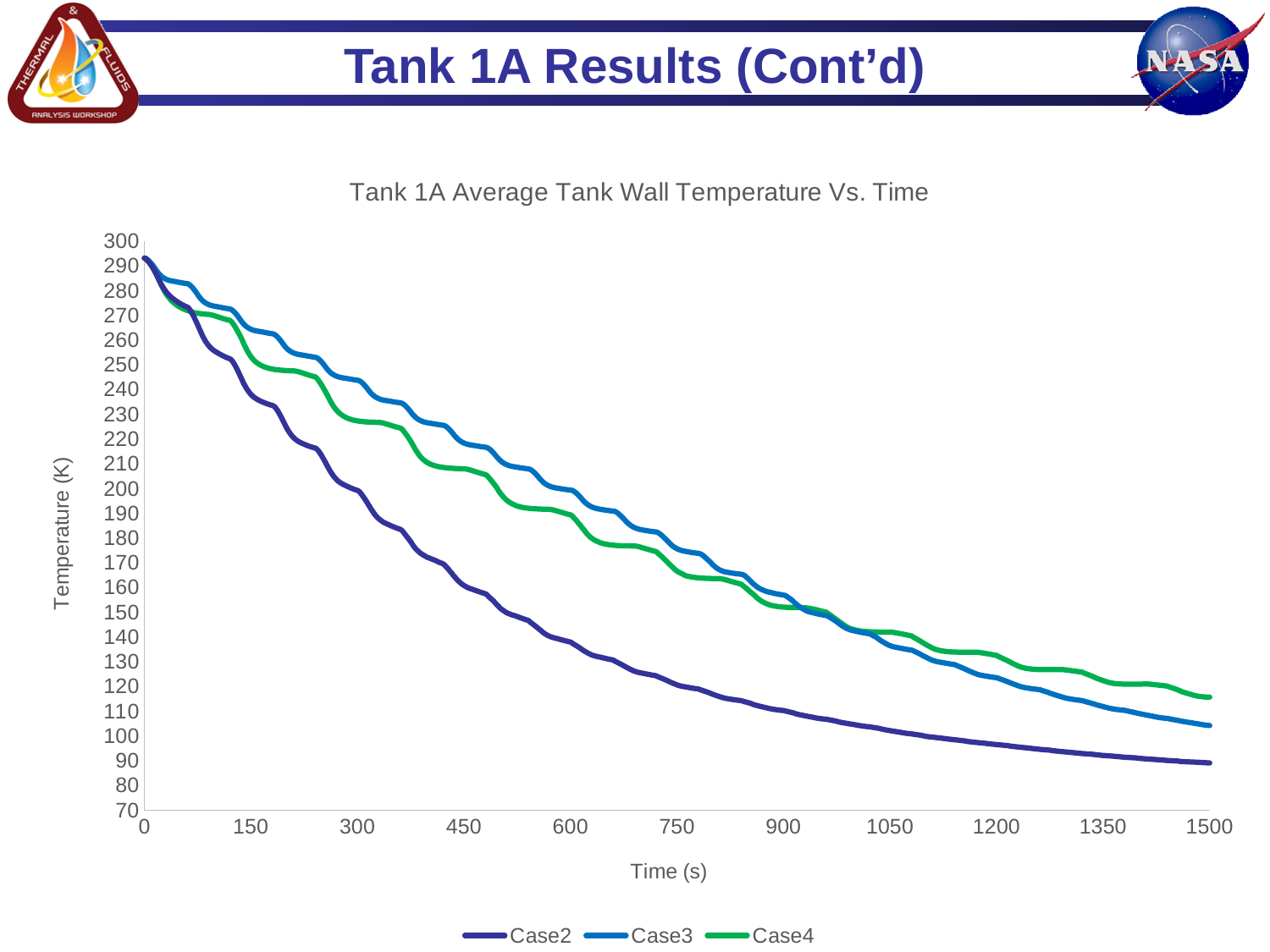
At 300 s, which series has the higher temperature, Case2 or Case3? Case3 What is the label of the y axis? Temperature (K) How many series does the legend list? 3 Is the temperature for Case2 at 1500 s greater or less than 100? less What kind of chart is shown on the slide? line chart What is the title of the chart? Tank 1A Average Tank Wall Temperature Vs. Time At 150 s, which series has the higher temperature, Case3 or Case4? Case3 Which series has the lowest temperature at 1500 s? Case2 Is the temperature for Case2 at 750 s greater or less than 150? less Which series has the highest temperature at 1500 s? Case4 Is the temperature for Case3 at 300 s greater or less than 200? greater Do the temperature values for Case2 rise or fall as time increases? fall